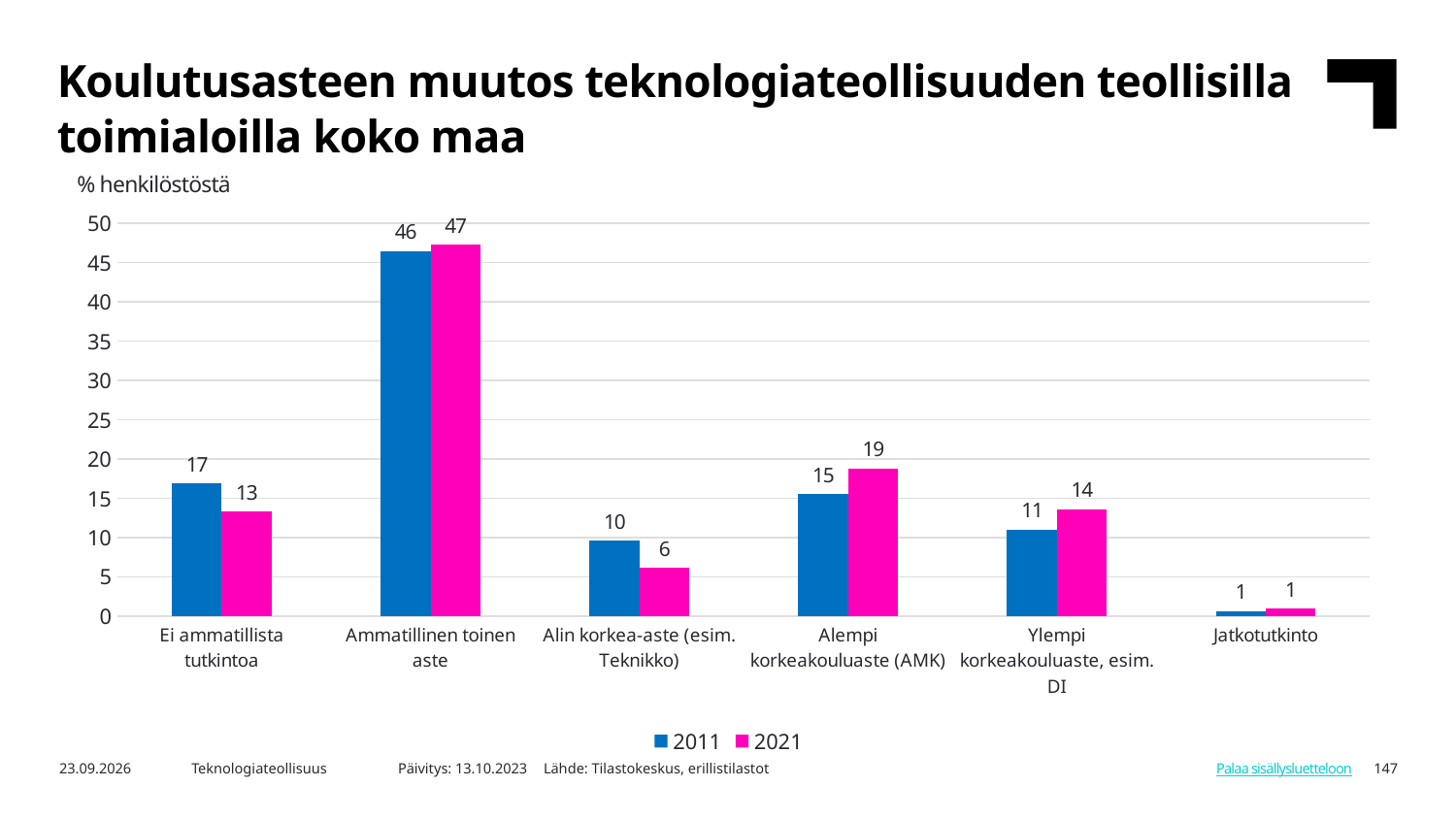
What is the difference between the 2011 and 2021 values for Alin korkea-aste (esim. Teknikko)? 4 Is the value for 2011 for Ammatillinen toinen aste greater or less than 40? greater Which is larger for Ylempi korkeakouluaste, esim. DI: the 2011 value or the 2021 value? 2021 What kind of chart is shown on the slide? bar chart How many series does the legend list? 2 What is the value for 2021 for Ammatillinen toinen aste? 47 What is the value for 2011 for Ei ammatillista tutkintoa? 17 Which category has the lowest value for 2021? Jatkotutkinto What unit label is shown above the chart? % henkilöstöstä How many categories are shown on the x axis? 6 What is the value for 2021 for Alempi korkeakouluaste (AMK)? 19 Which category has the highest value for 2011? Ammatillinen toinen aste